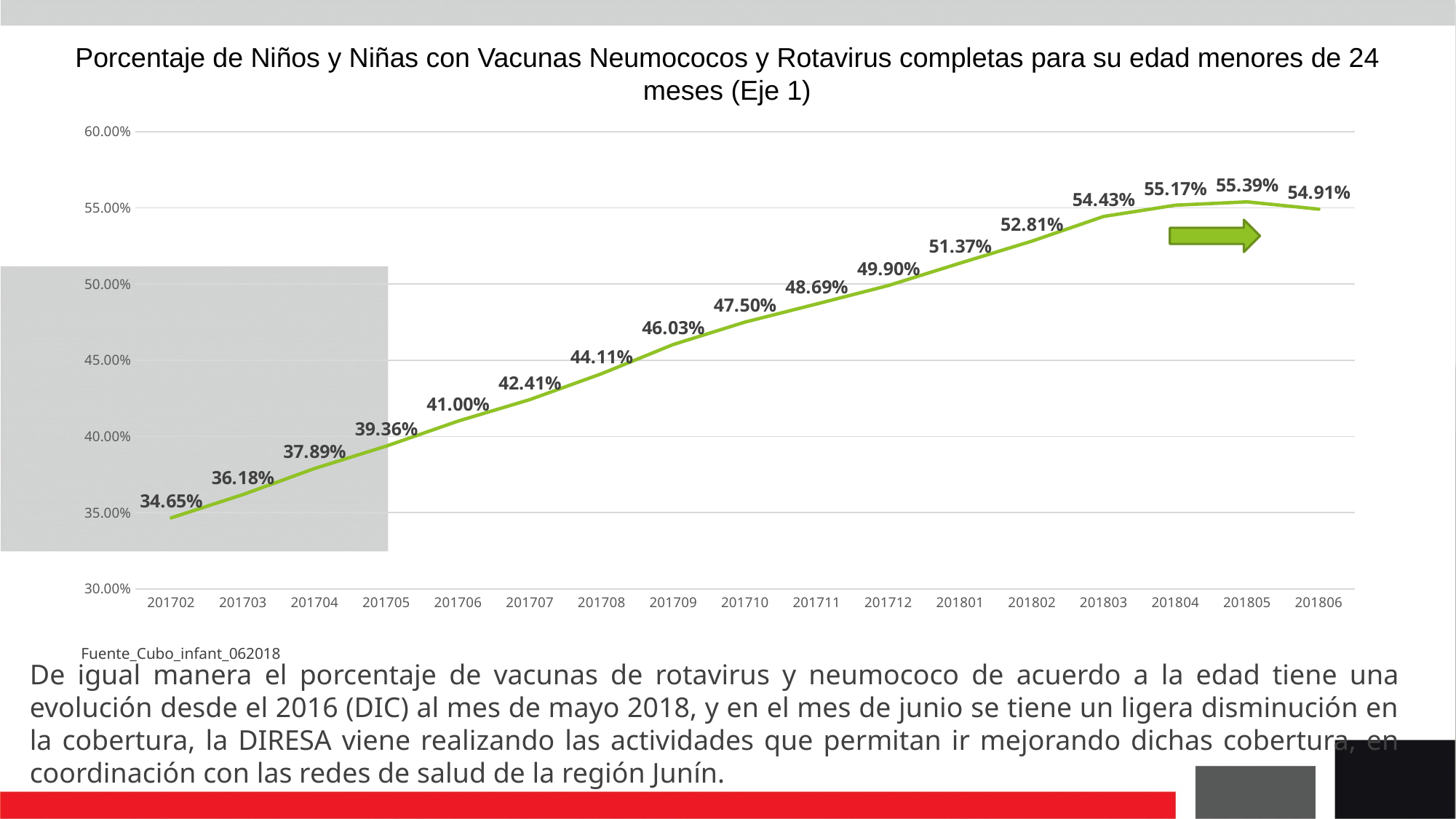
Which is larger, the value for 201804 or the value for 201806? 201804 What is the value for 201806? 54.91% What is the difference between the values for 201702 and 201806? 20.26% Which period has the lowest value? 201702 What is the value for 201712? 49.90% How many data points are plotted on the chart? 17 Do the values generally rise or fall from 201702 to 201805? rise Is the value for 201709 greater or less than 45.00%? greater Which period has the highest value? 201805 What is the value for 201702? 34.65% What is the difference between the values for 201806 and 201805? 0.48% What type of chart is shown on the slide? line chart